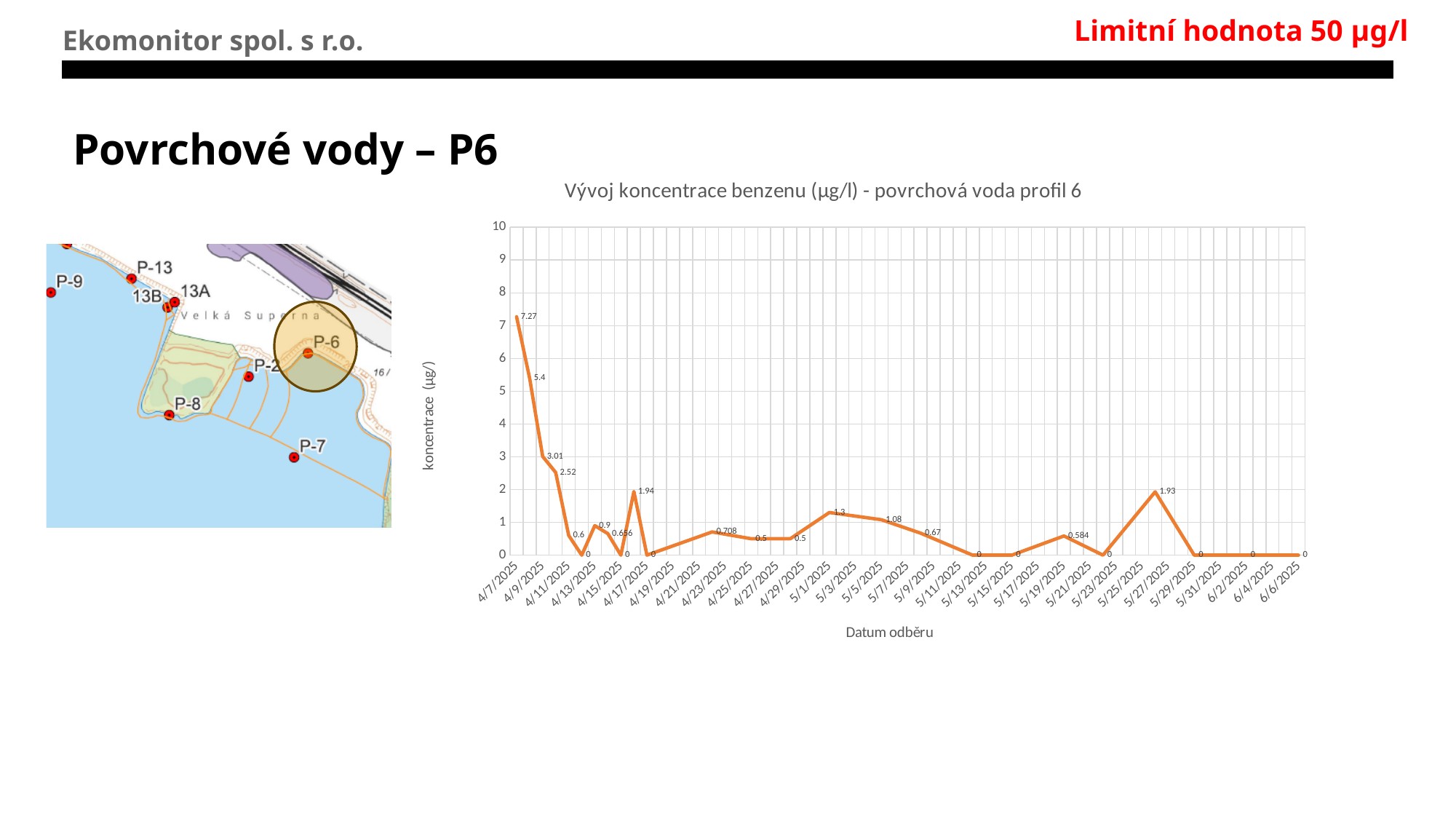
What is the benzene concentration on 5/1/2025? 1.3 What is the benzene concentration on 4/7/2025? 7.27 What is the benzene concentration on 6/6/2025, the last date on the chart? 0 What is the benzene concentration on 5/5/2025? 1.08 Is the benzene concentration on 4/7/2025 greater or less than 5? greater What is the highest benzene concentration value plotted on the chart? 7.27 What is the label of the x axis of the chart? Datum odběru What type of chart is shown on the slide? line chart Overall, do the benzene concentration values rise or fall from 4/7/2025 to 6/6/2025? fall What is the difference between the first plotted value (7.27) and the second plotted value (5.4)? 1.87 What is the title of the chart? Vývoj koncentrace benzenu (µg/l) - povrchová voda profil 6 What is the benzene concentration on 5/19/2025? 0.584